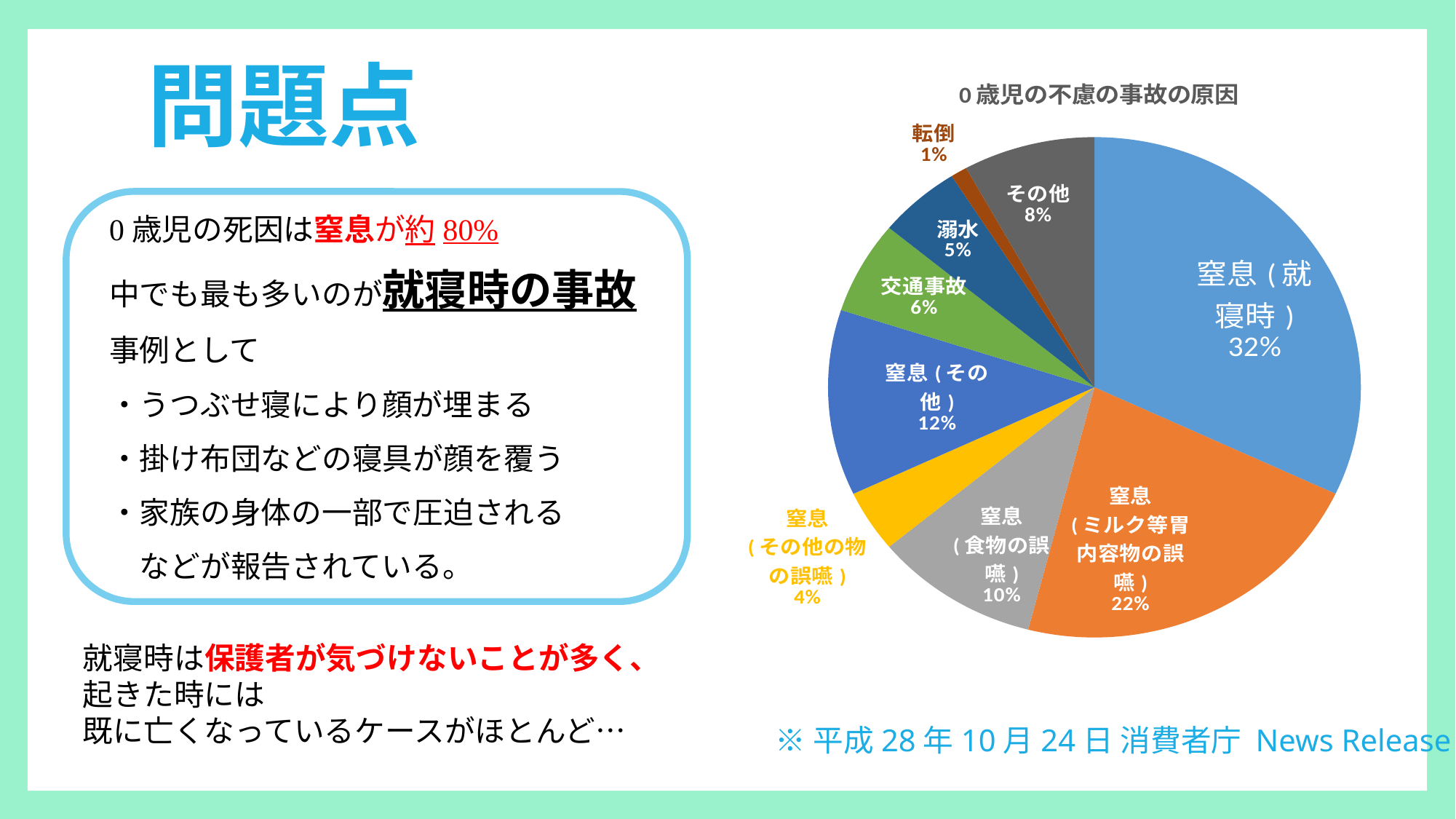
Which category has the smallest slice of the pie? 転倒 What share of the pie does 窒息（就寝時） account for? 32% Which category has the largest slice of the pie? 窒息（就寝時） What is the difference in percentage points between 窒息（食物の誤嚥） and 窒息（その他の物の誤嚥）? 6 What percentage is shown for 窒息（ミルク等胃内容物の誤嚥）? 22% What percentage is shown for 溺水? 5% Which is larger, the slice for 窒息（その他） or the slice for その他? 窒息（その他） What percentage is shown for 交通事故? 6% What type of chart is shown on the slide? pie chart What is the difference in percentage points between 窒息（就寝時） and 窒息（ミルク等胃内容物の誤嚥）? 10 How many slices does the pie chart have? 9 What is the title of the pie chart? 0歳児の不慮の事故の原因